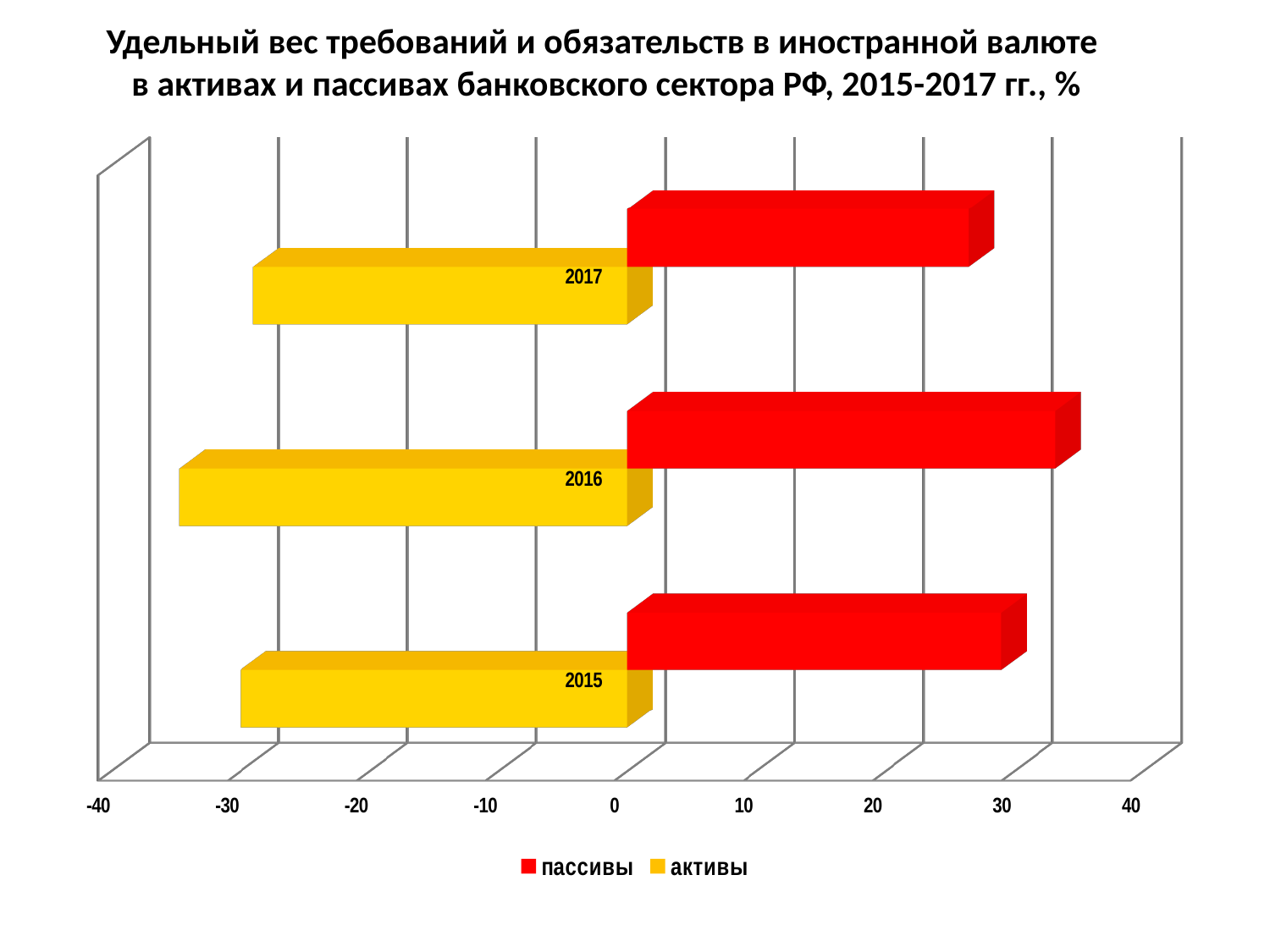
Which year has the most negative value for активы? 2016 Which is larger: пассивы in 2016 or пассивы in 2015? пассивы in 2016 What kind of chart is shown on the slide? bar chart Is the value for активы in 2016 greater or less than -30? less Is the value for пассивы in 2017 greater or less than 30? less How many series does the legend list? 2 How many years (categories) are plotted on the chart? 3 Which colour represents the series активы in the legend? yellow Which series is shown in red? пассивы Which year has the highest value for пассивы? 2016 Which year has the lowest value for пассивы? 2017 Is the value for пассивы in 2016 greater or less than 30? greater